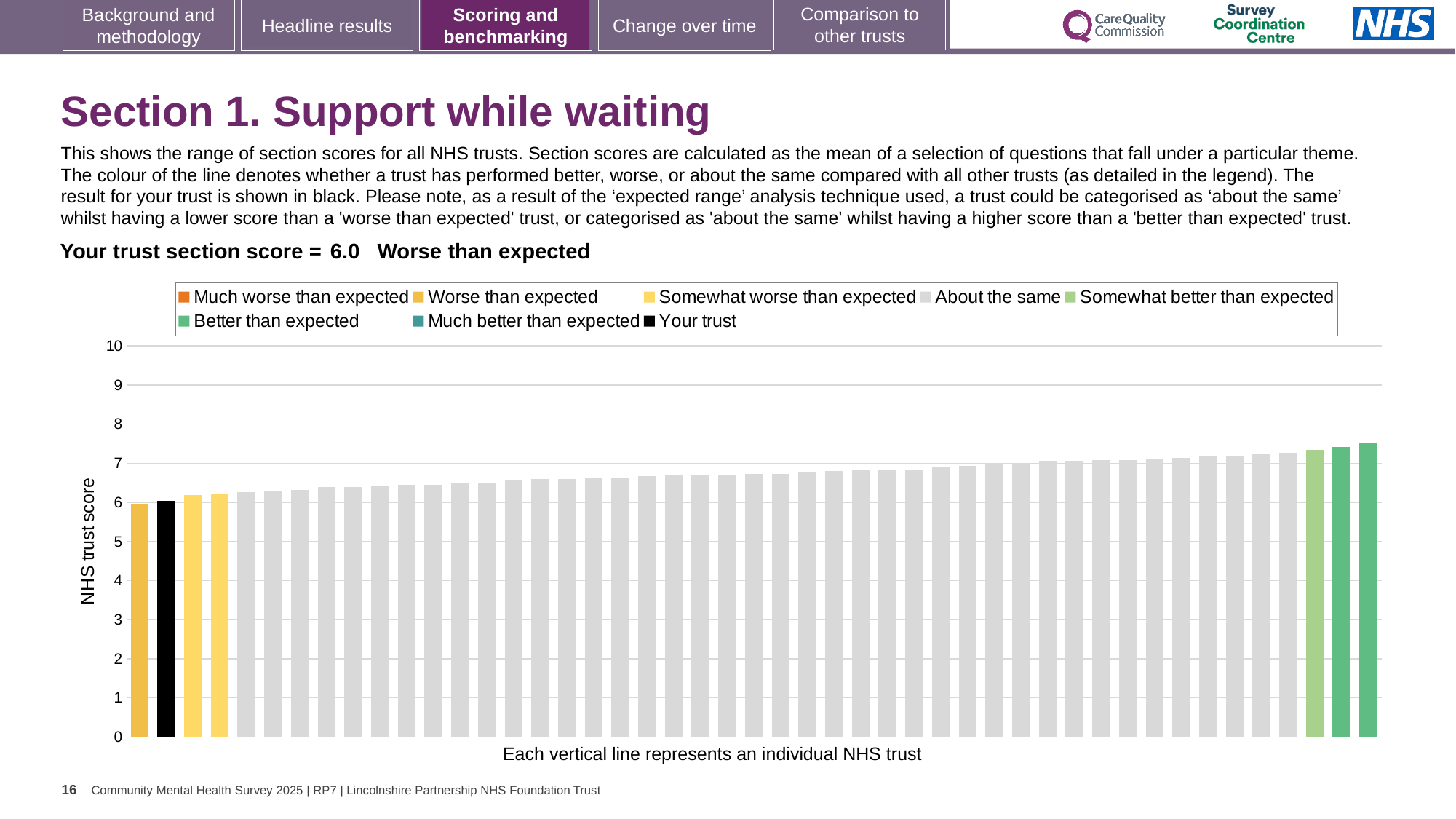
What is the label on the vertical axis of the chart? NHS trust score How many entries does the chart legend list? 8 Is the value for the rightmost trust bar greater or less than 8? less What is the section score for your trust? 6.0 Is the value for the rightmost trust bar greater or less than 7? greater Do the trust scores rise or fall moving from left to right along the x axis? rise Is the value for your trust (the black bar) greater or less than 7? less Is your trust's score (the black bar) higher or lower than the rightmost trust's score? lower Which performance category is your trust's section score assigned to? Worse than expected According to the caption below the chart, what does each vertical line represent? An individual NHS trust What kind of chart is shown on the slide? bar chart